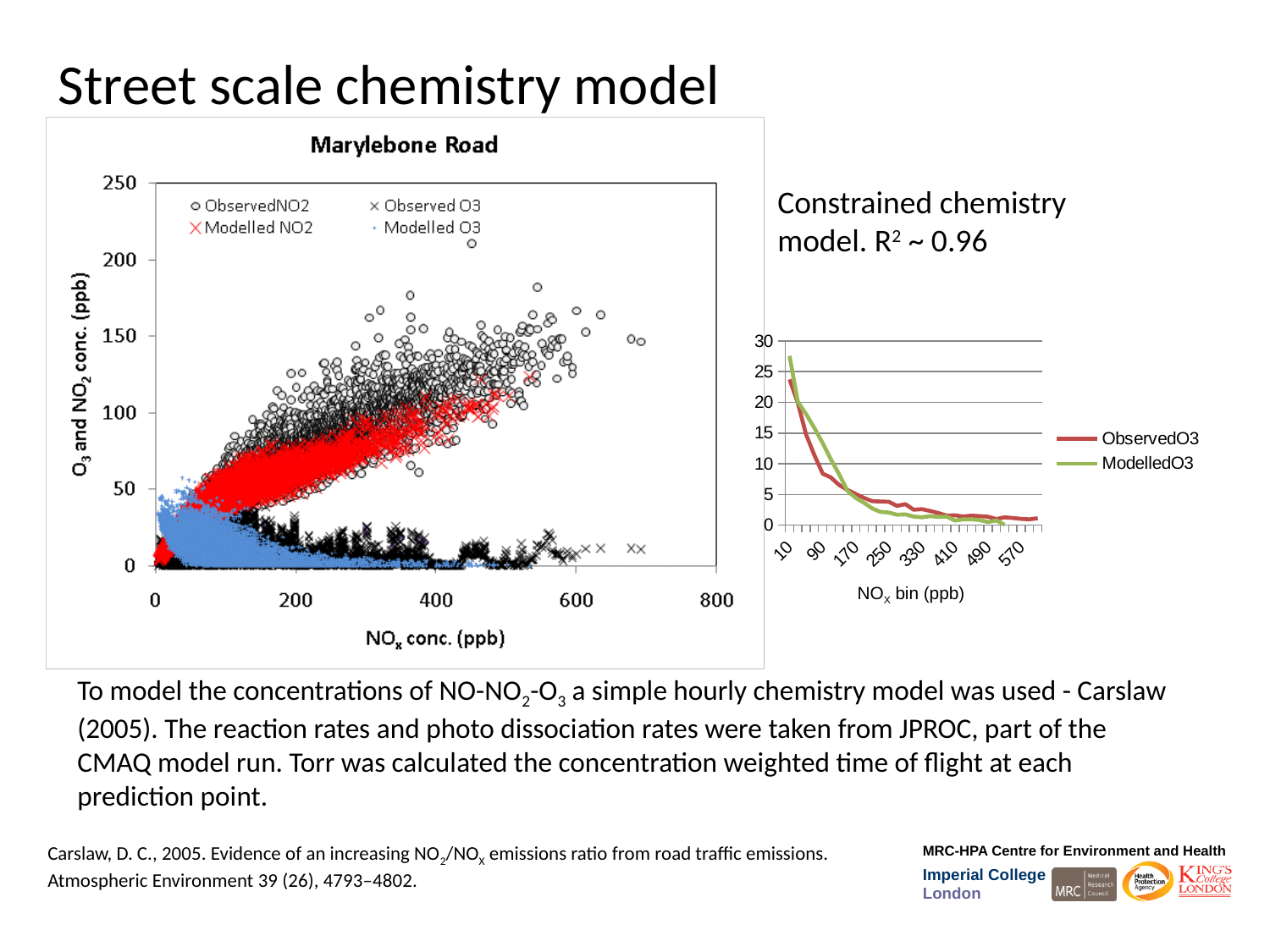
In the chart on the right, is the ObservedO3 value at the NOx bin of 10 greater or less than 20? greater What is the title of the scatter chart on the left? Marylebone Road In the chart on the right, at which NOx bin is ObservedO3 highest? 10 What kind of chart is the chart on the right of the slide (ObservedO3 / ModelledO3)? line chart In the Marylebone Road chart, how many series does the legend list? 4 In the chart on the right, at the NOx bin of 10, which series has the higher value, ObservedO3 or ModelledO3? ModelledO3 In the chart on the right, is the ObservedO3 value at the NOx bin of 250 greater or less than 10? less What is the x-axis label of the chart on the right? NOx bin (ppb) In the chart on the right, do the ObservedO3 values rise or fall as the NOx bin increases? fall What kind of chart is the Marylebone Road chart? scatter chart In the chart on the right, do the ModelledO3 values rise or fall as the NOx bin increases? fall In the chart on the right, how many series does the legend list? 2